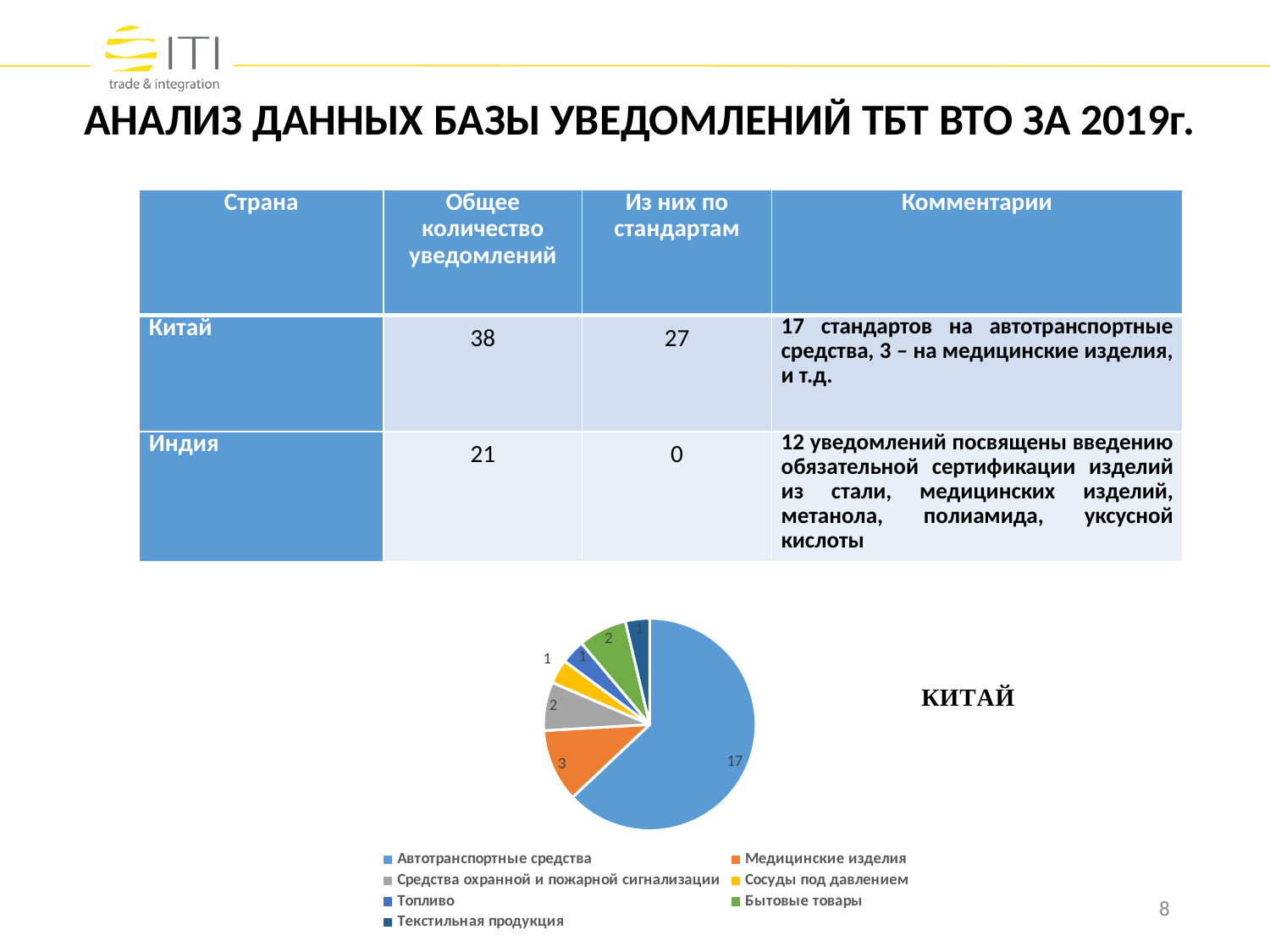
What title is shown next to the pie chart? КИТАЙ What is the value for Сосуды под давлением in the pie chart? 1 What is the value for Автотранспортные средства in the pie chart? 17 Which is larger in the pie chart: Медицинские изделия or Средства охранной и пожарной сигнализации? Медицинские изделия What is the difference between the values for Автотранспортные средства and Медицинские изделия? 14 Which category is shown in orange in the pie chart? Медицинские изделия What is the value for Бытовые товары in the pie chart? 2 What is the total of all slices in the pie chart? 27 What kind of chart is shown on the slide? pie chart What is the value for Медицинские изделия in the pie chart? 3 Which category has the largest slice in the pie chart? Автотранспортные средства How many categories does the pie chart legend list? 7